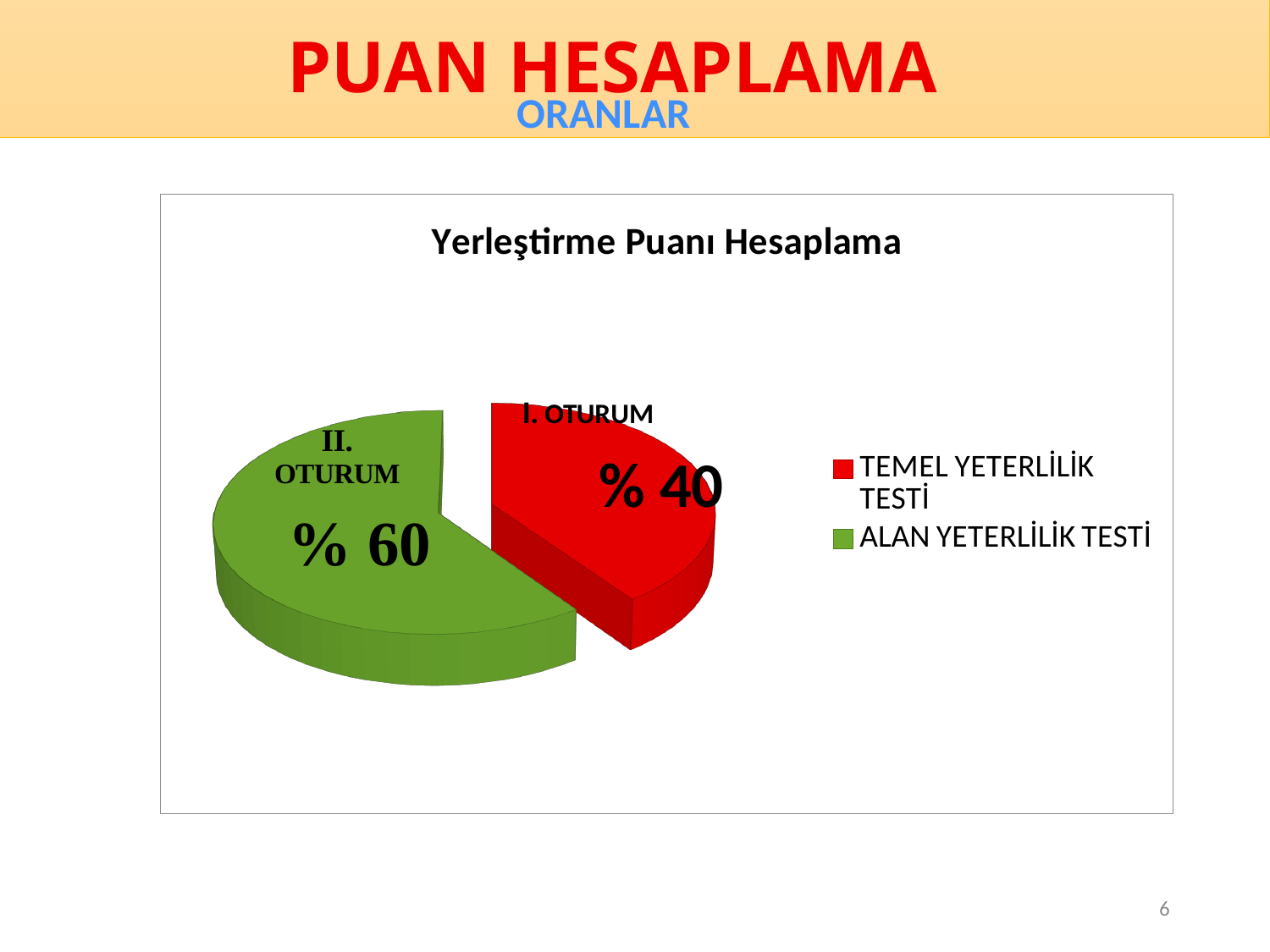
Which slice is the smallest in the pie chart? TEMEL YETERLİLİK TESTİ What share of the pie does the TEMEL YETERLİLİK TESTİ (I. OTURUM) slice represent? % 40 Which is larger, the I. OTURUM slice or the II. OTURUM slice? II. OTURUM What kind of chart is shown on the slide? pie chart What colour is the ALAN YETERLİLİK TESTİ slice? green What share of the pie does the ALAN YETERLİLİK TESTİ (II. OTURUM) slice represent? % 60 How many slices does the pie chart have? 2 What is the title of the chart? Yerleştirme Puanı Hesaplama How many entries does the legend list? 2 Which slice is the largest in the pie chart? ALAN YETERLİLİK TESTİ What is the difference in percentage points between the II. OTURUM slice and the I. OTURUM slice? 20